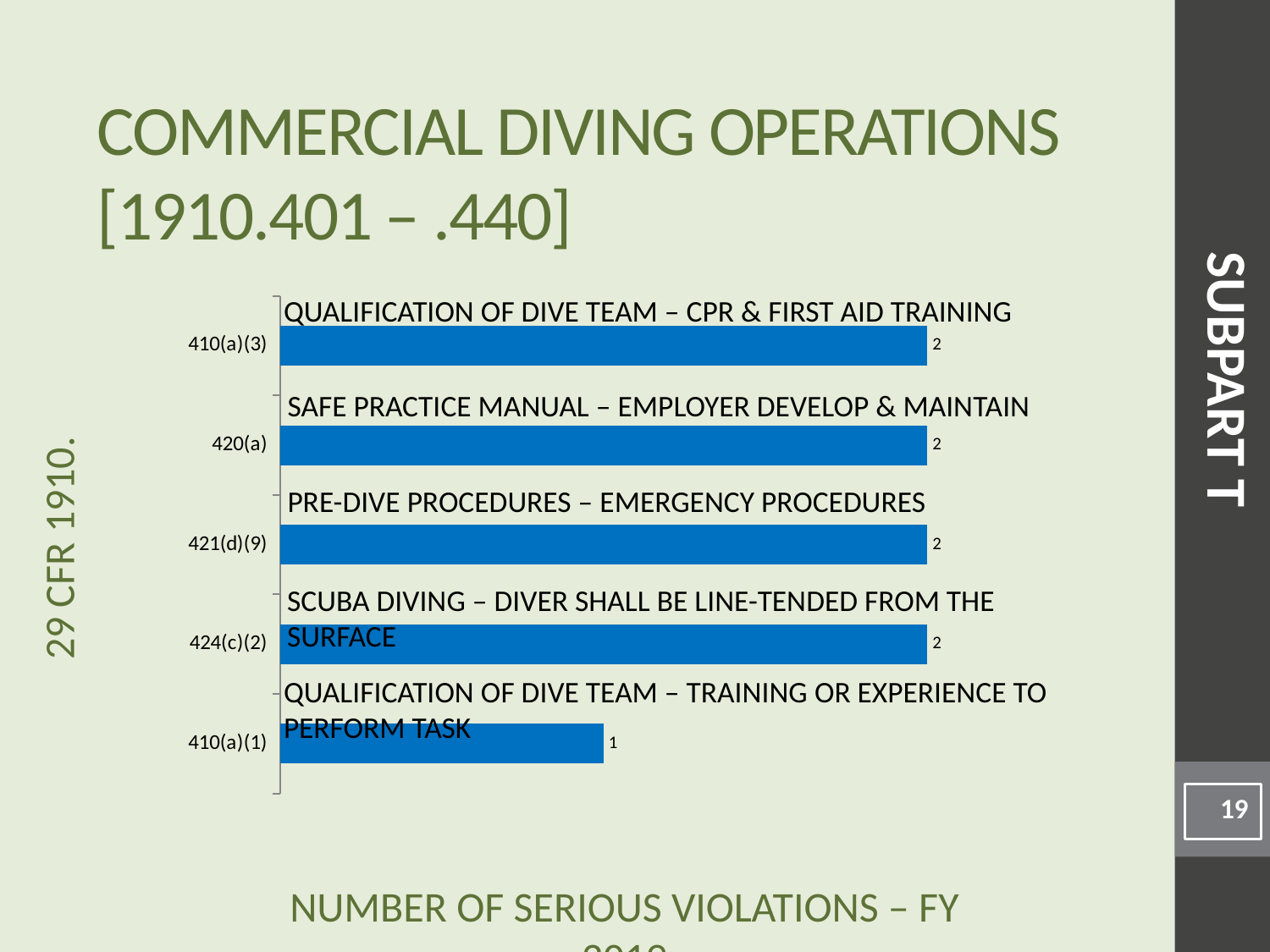
What is the total of all the values plotted in the chart? 9 What kind of chart is shown on the slide? Bar chart What is the value shown for 424(c)(2)? 2 How many categories have a value of 2? 4 What is the number of serious violations for 410(a)(1)? 1 What colour are the bars in the chart? Blue Which category has the lowest number of serious violations? 410(a)(1) What is the number of serious violations for 410(a)(3)? 2 How many categories are plotted in the chart? 5 What is the difference between the values for 420(a) and 410(a)(1)? 1 Which is larger, the value for 420(a) or the value for 410(a)(1)? 420(a) What is the value shown for 421(d)(9)? 2